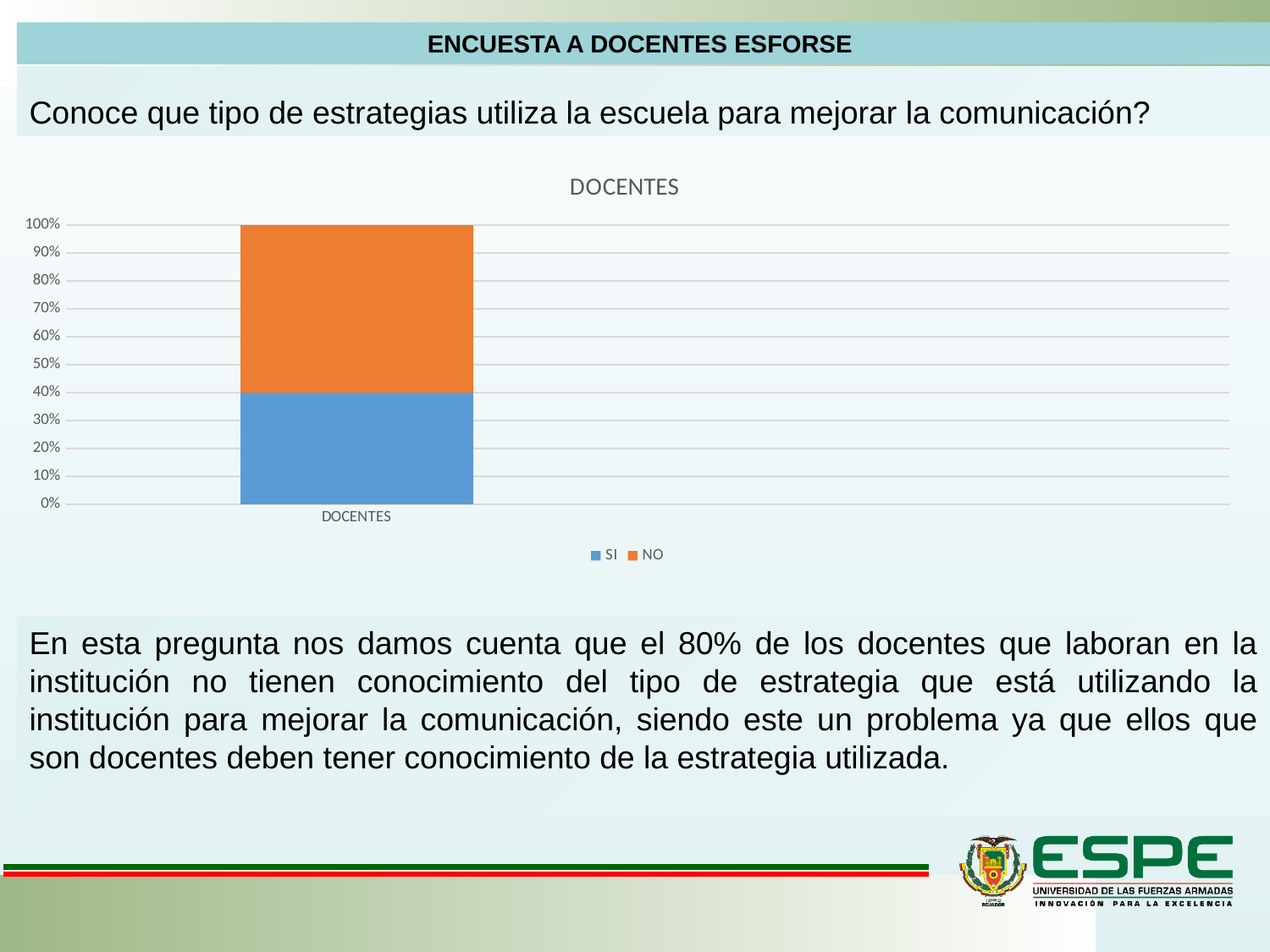
Which series has the larger share for DOCENTES, SI or NO? NO Is the NO segment for DOCENTES greater or less than 50%? greater What is the label of the single category on the x axis? DOCENTES What percentage does the SI (blue) segment reach for DOCENTES? 40% How many categories are plotted on the x axis? 1 What are the two series named in the legend? SI and NO Is the SI segment for DOCENTES greater or less than 50%? less What is the title of the chart? DOCENTES What is the total height of the stacked bar for DOCENTES? 100% What kind of chart is shown on the slide? Stacked bar chart What is the highest value shown on the y axis? 100% How many series does the chart legend list? 2